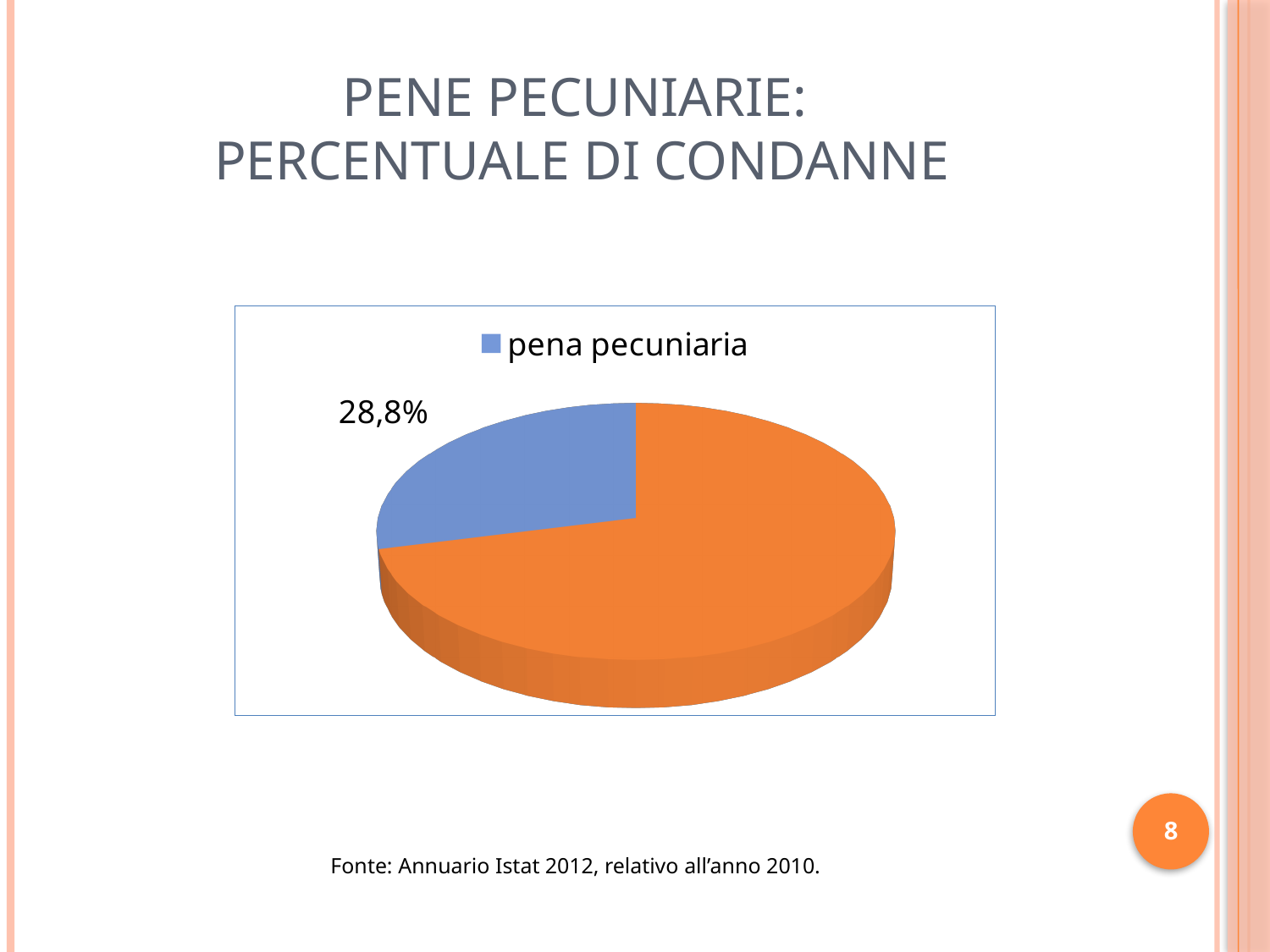
What kind of chart is shown on the slide? pie chart How many slices does the pie chart have? 2 How many entries does the chart legend list? 1 Which slice is larger, the blue one or the orange one? the orange one What colour is the "pena pecuniaria" slice? blue What share of the pie does "pena pecuniaria" represent? 28,8% What percentage is shown for the "pena pecuniaria" slice? 28,8% Which is the smallest slice of the pie? pena pecuniaria What is the only entry listed in the chart legend? pena pecuniaria Is the "pena pecuniaria" slice the largest slice of the pie? No